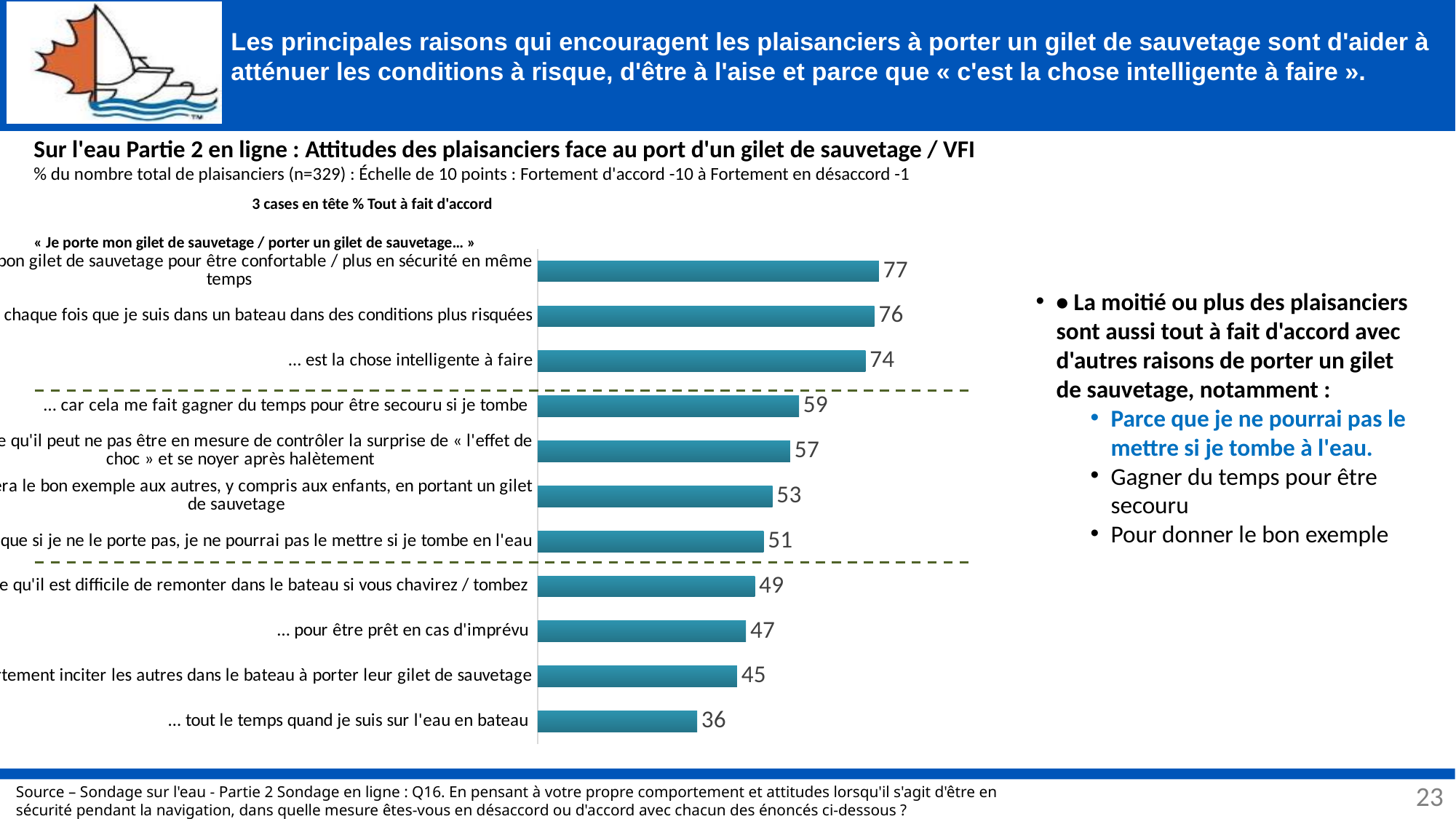
What is the value for "... tout le temps quand je suis sur l'eau en bateau"? 36 What is the difference between the values for "... est la chose intelligente à faire" and "... tout le temps quand je suis sur l'eau en bateau"? 38 What type of chart is shown on the slide? Bar chart How many bars are shown in the chart? 11 What is the difference between the values for "... car cela me fait gagner du temps pour être secouru si je tombe" and "... pour être prêt en cas d'imprévu"? 12 What is the value for "... car cela me fait gagner du temps pour être secouru si je tombe"? 59 Do the bar values increase or decrease from top to bottom of the chart? Decrease What is the value for "... est la chose intelligente à faire"? 74 What is the highest value shown in the chart? 77 Which statement has the lowest value in the chart? ... tout le temps quand je suis sur l'eau en bateau Which has a larger value: "... pour être prêt en cas d'imprévu" or "... tout le temps quand je suis sur l'eau en bateau"? ... pour être prêt en cas d'imprévu What is the value for "... pour être prêt en cas d'imprévu"? 47